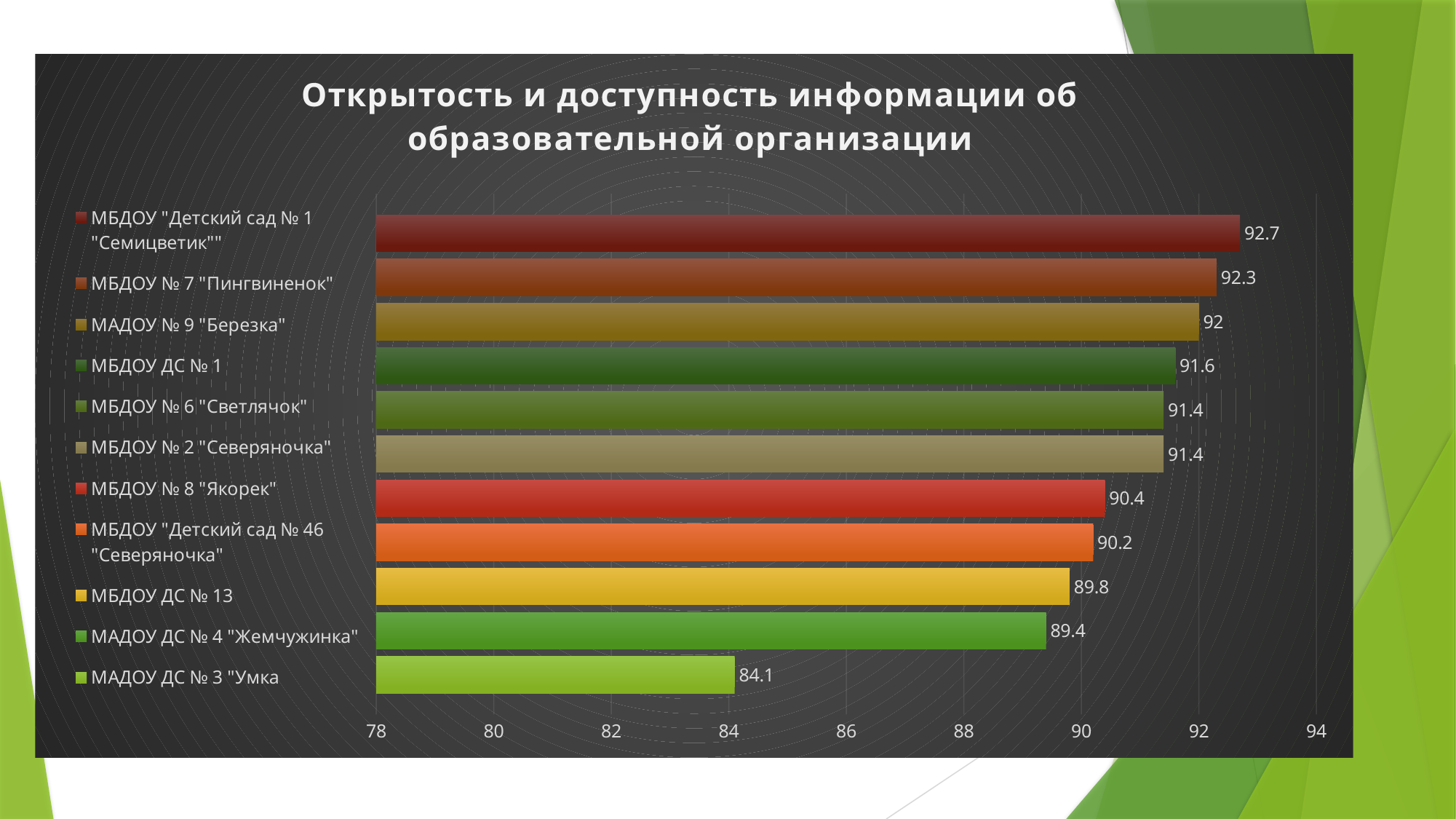
How many organisations are shown in the chart? 11 Which organisation has the lowest value? МАДОУ ДС № 3 "Умка" Is the value for МАДОУ ДС № 3 "Умка" greater or less than 86? less What is the difference between the values for МАДОУ № 9 "Березка" and МАДОУ ДС № 4 "Жемчужинка"? 2.6 What is the value for МБДОУ ДС № 13? 89.8 What is the value for МБДОУ № 7 "Пингвиненок"? 92.3 What is the value for МБДОУ № 8 "Якорек"? 90.4 Which organisation has the highest value? МБДОУ "Детский сад № 1 "Семицветик"" What is the title of the chart? Открытость и доступность информации об образовательной организации Which is larger, the value for МБДОУ ДС № 1 or the value for МБДОУ "Детский сад № 46 "Северяночка"? МБДОУ ДС № 1 What is the value for МАДОУ ДС № 3 "Умка"? 84.1 What kind of chart is shown on the slide? bar chart